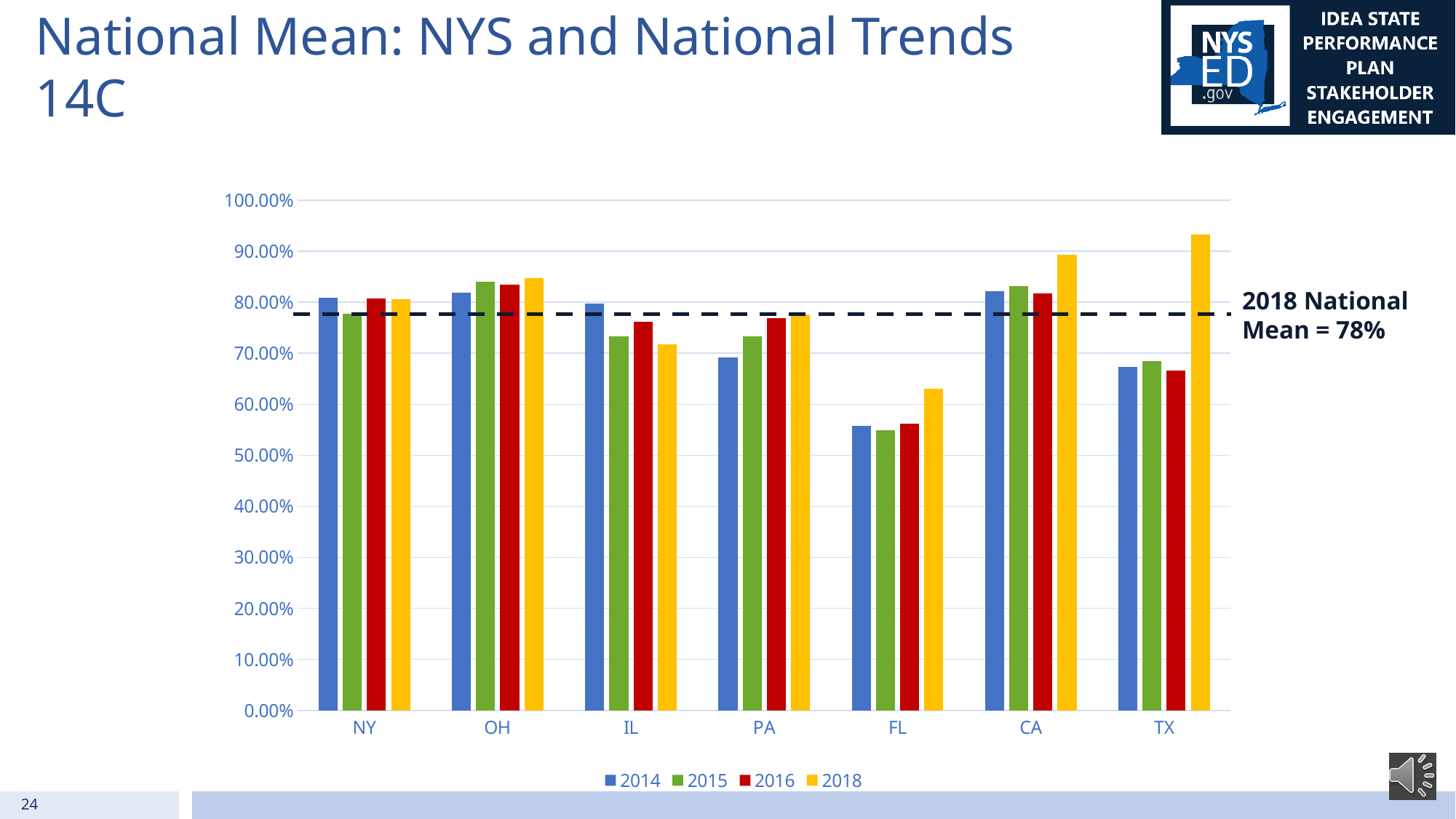
Which is larger, the 2018 value for CA or the 2018 value for OH? CA Is the 2018 value for TX greater or less than 90.00%? greater Is the 2014 value for FL greater or less than 60.00%? less Do the values for PA rise or fall from 2014 to 2018? rise Which state has the lowest 2014 value? FL Which years are listed in the chart legend? 2014, 2015, 2016, 2018 Which state has the lowest 2018 value? FL How many series does the chart legend list? 4 How many states are shown on the x axis of the chart? 7 What does the dashed horizontal line on the chart represent? 2018 National Mean = 78% Which state has the highest 2018 value? TX What kind of chart is shown on the slide? Bar chart